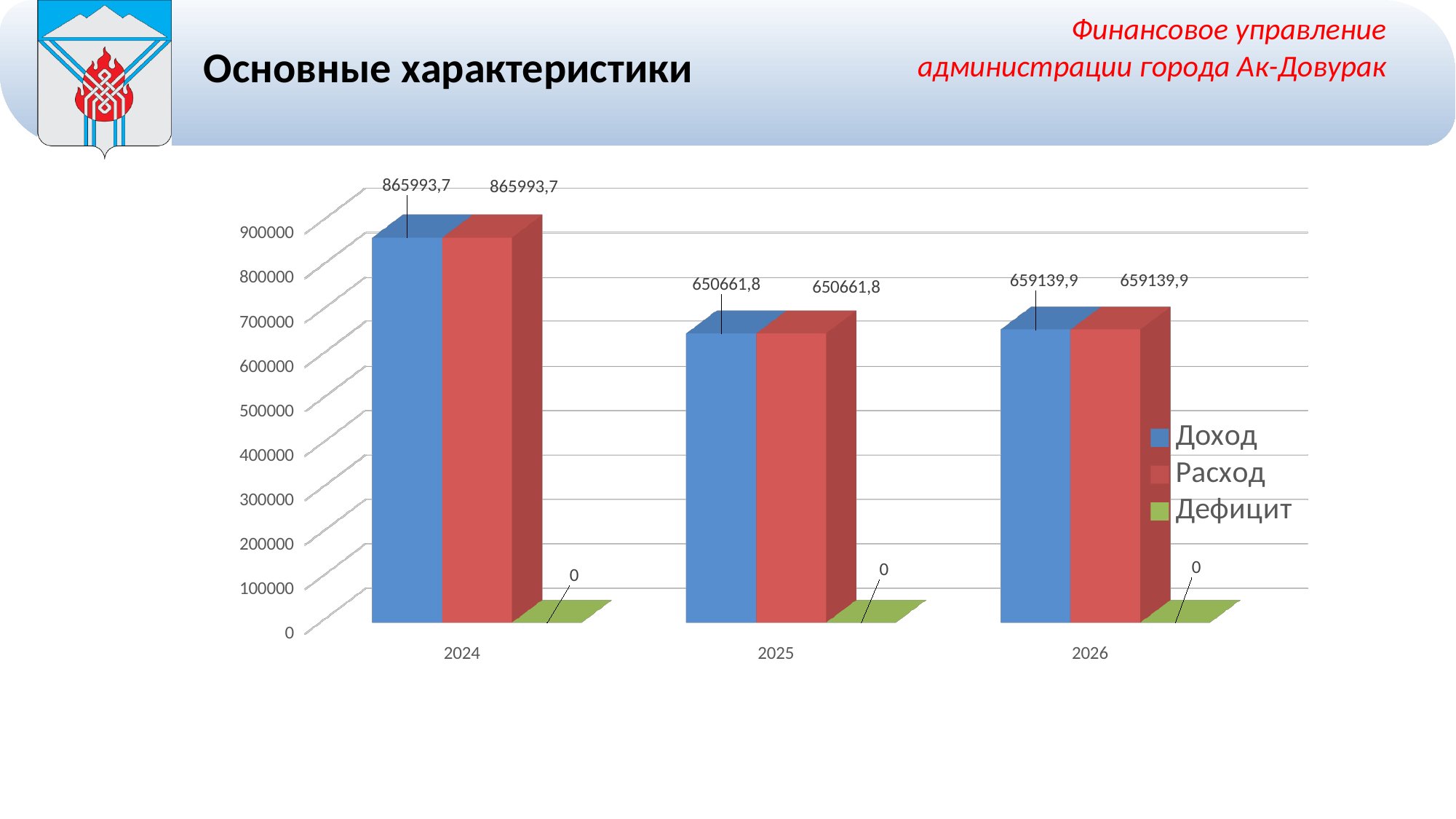
How many series does the legend list? 3 Is the value of Доход for 2025 greater or less than 700000? less What is the value of Доход for 2024? 865993,7 In which year is Доход the highest? 2024 What is the value of Доход for 2026? 659139,9 What is the difference between Доход in 2024 and Доход in 2025? 215331,9 What is the value of Расход for 2025? 650661,8 Which is larger: Расход in 2026 or Расход in 2025? Расход in 2026 What kind of chart is shown on the slide? Bar chart In which year is Расход the lowest? 2025 How many years are shown on the x axis? 3 What is the value of Дефицит for 2025? 0